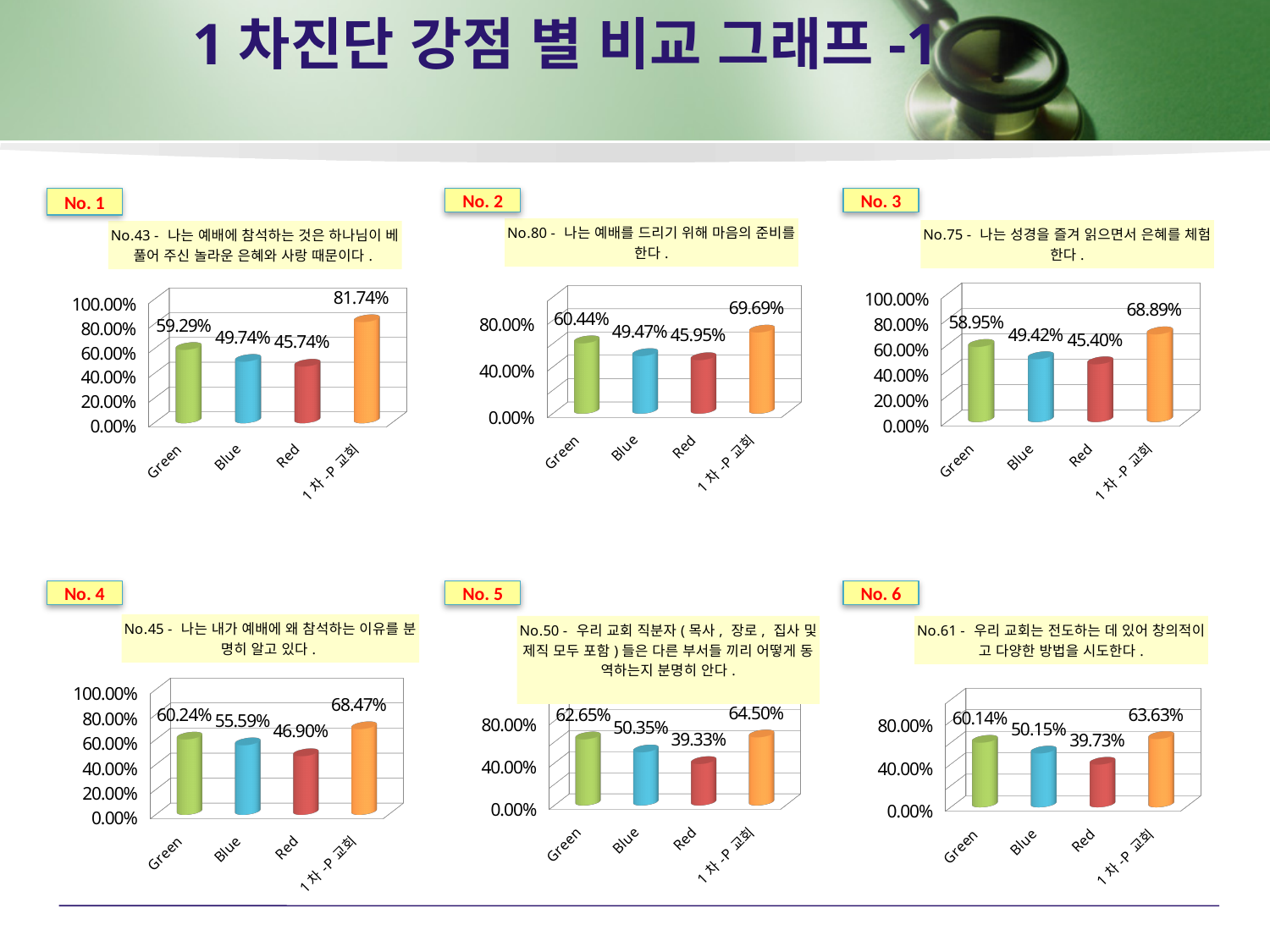
In the No. 4 chart, what is the value for Blue? 55.59% In the No. 6 chart, what is the difference between the 1차-P 교회 value and the Green value? 3.49% In the No. 3 chart, which category has the lowest value? Red In the No. 5 chart, what is the difference between the Green value and the Red value? 23.32% What kind of chart is the No. 3 chart? bar chart In the No. 6 chart, which is larger, the value for Blue or the value for Red? Blue In the No. 1 chart, what is the value for 1차-P 교회? 81.74% How many charts are shown on the slide? 6 In the No. 4 chart, which category has the highest value? 1차-P 교회 In the No. 2 chart, what is the value for Green? 60.44% In the No. 1 chart, is the value for Red greater or less than 40.00%? greater How many categories are shown on the x axis of the No. 2 chart? 4